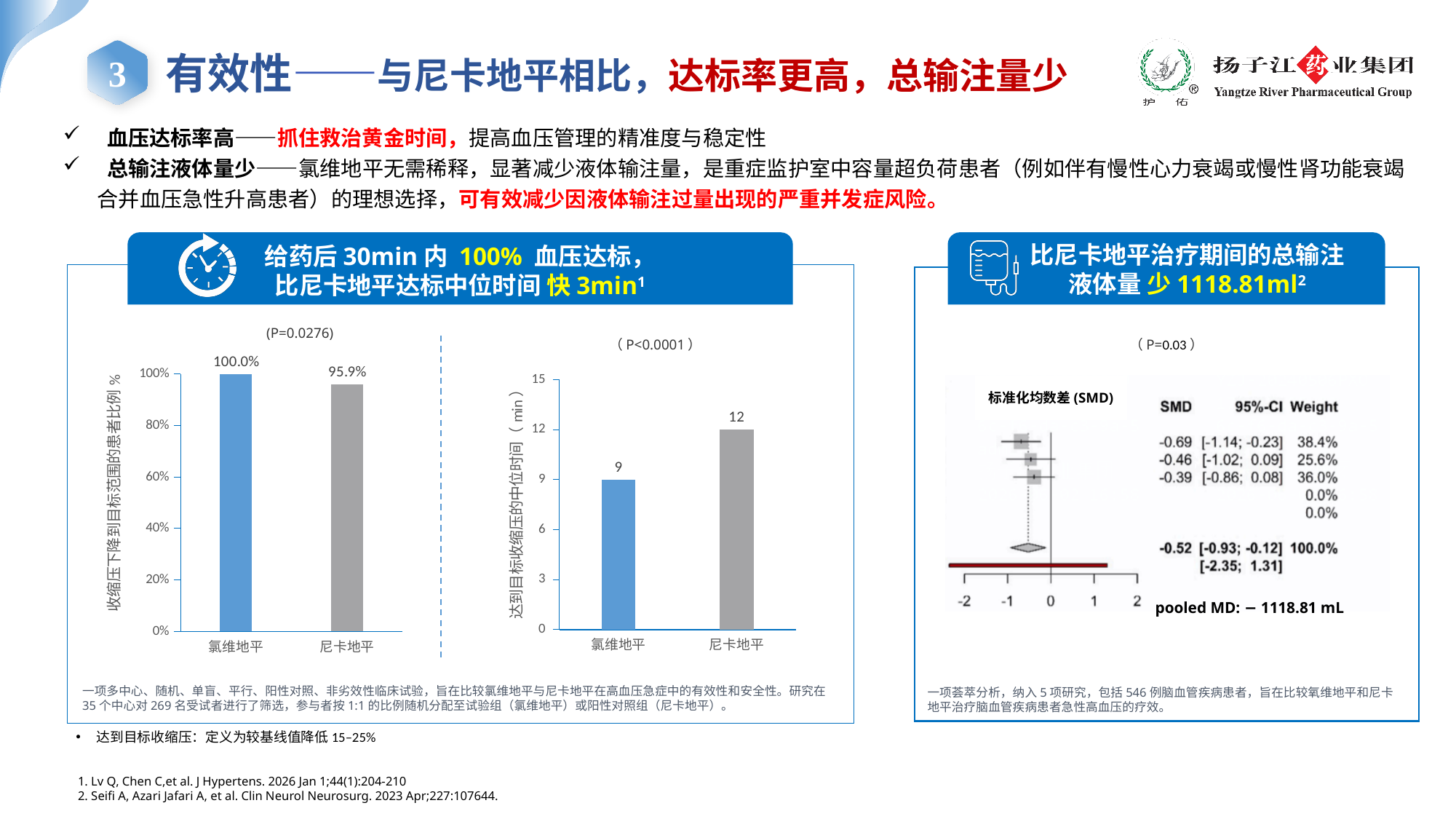
In the left bar chart (收缩压下降到目标范围的患者比例), what is the difference between the values for 氯维地平 and 尼卡地平? 4.1% In the left bar chart (收缩压下降到目标范围的患者比例), what is the value for 氯维地平? 100.0% In the left bar chart (收缩压下降到目标范围的患者比例), which category has the lower value? 尼卡地平 In the left bar chart (收缩压下降到目标范围的患者比例), what is the value for 尼卡地平? 95.9% In the middle bar chart (达到目标收缩压的中位时间), what is the value for 尼卡地平? 12 What kind of chart is the left chart (收缩压下降到目标范围的患者比例)? bar chart In the middle bar chart (达到目标收缩压的中位时间), what is the value for 氯维地平? 9 In the right forest plot, what is the pooled MD shown? − 1118.81 mL How many categories are shown in the middle bar chart (达到目标收缩压的中位时间)? 2 In the right forest plot, what is the weight of the study with SMD -0.69? 38.4% In the middle bar chart (达到目标收缩压的中位时间), which category has the higher value? 尼卡地平 In the middle bar chart (达到目标收缩压的中位时间), what is the difference between the values for 尼卡地平 and 氯维地平? 3